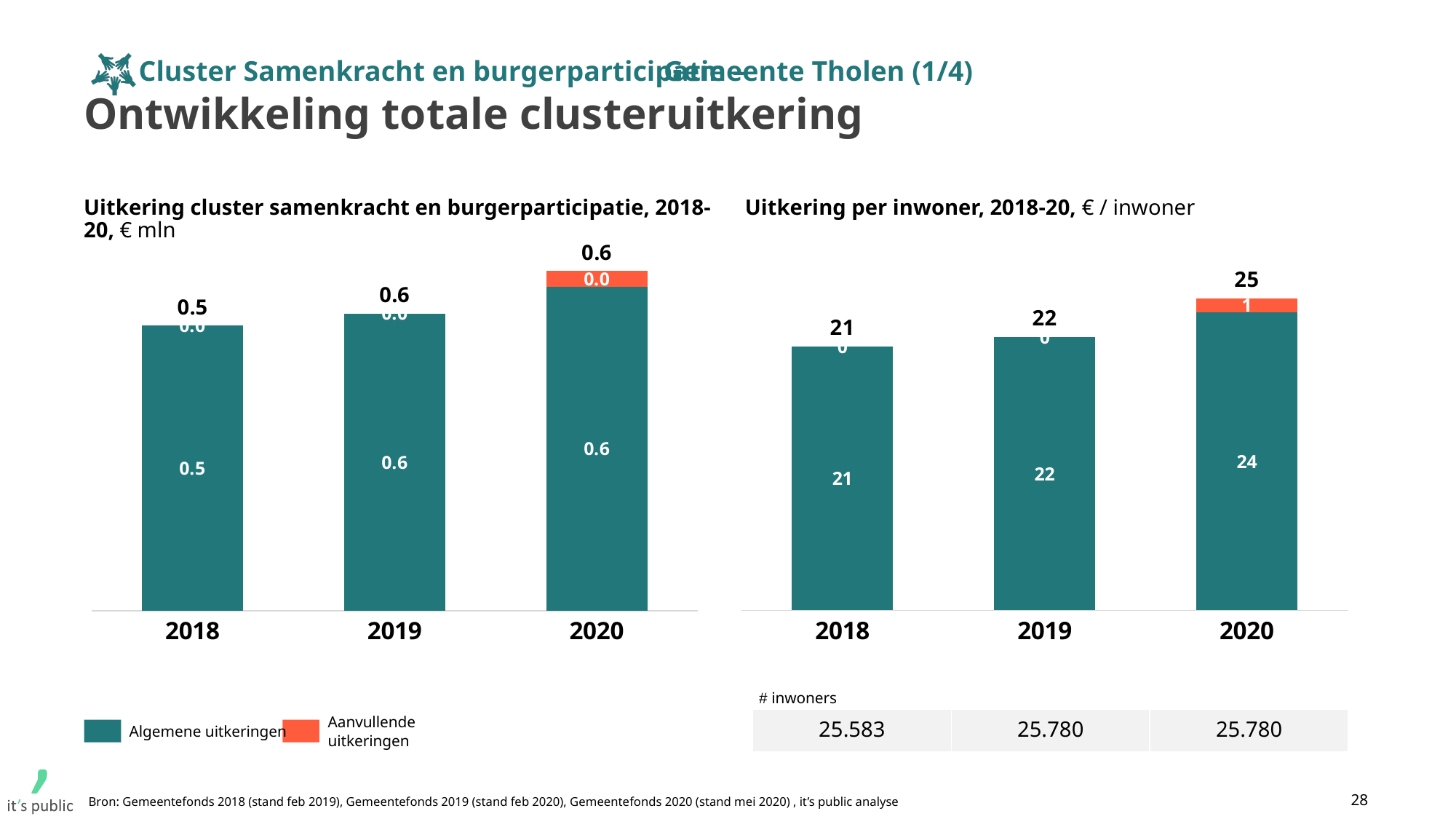
In the chart 'Uitkering per inwoner, 2018-20', what is the value of Aanvullende uitkeringen for 2020? 1 In the left chart 'Uitkering cluster samenkracht en burgerparticipatie, 2018-20', what is the total value for 2018? 0.5 In the chart 'Uitkering per inwoner, 2018-20', which year has the highest total? 2020 In the chart 'Uitkering per inwoner, 2018-20', what is the total value for 2020? 25 In the chart 'Uitkering per inwoner, 2018-20', what is the difference between the total for 2020 and the total for 2018? 4 How many series does the legend list for the charts on this slide? 2 In the chart 'Uitkering per inwoner, 2018-20', is the total for 2019 larger or smaller than the total for 2020? smaller In the chart 'Uitkering per inwoner, 2018-20', what is the value of Algemene uitkeringen for 2020? 24 What kind of chart is 'Uitkering per inwoner, 2018-20'? Stacked bar chart In the chart 'Uitkering per inwoner, 2018-20', which year has the lowest total? 2018 How many years are shown on the x axis of the left chart 'Uitkering cluster samenkracht en burgerparticipatie, 2018-20'? 3 In the left chart 'Uitkering cluster samenkracht en burgerparticipatie, 2018-20', what is the value of Algemene uitkeringen for 2019? 0.6